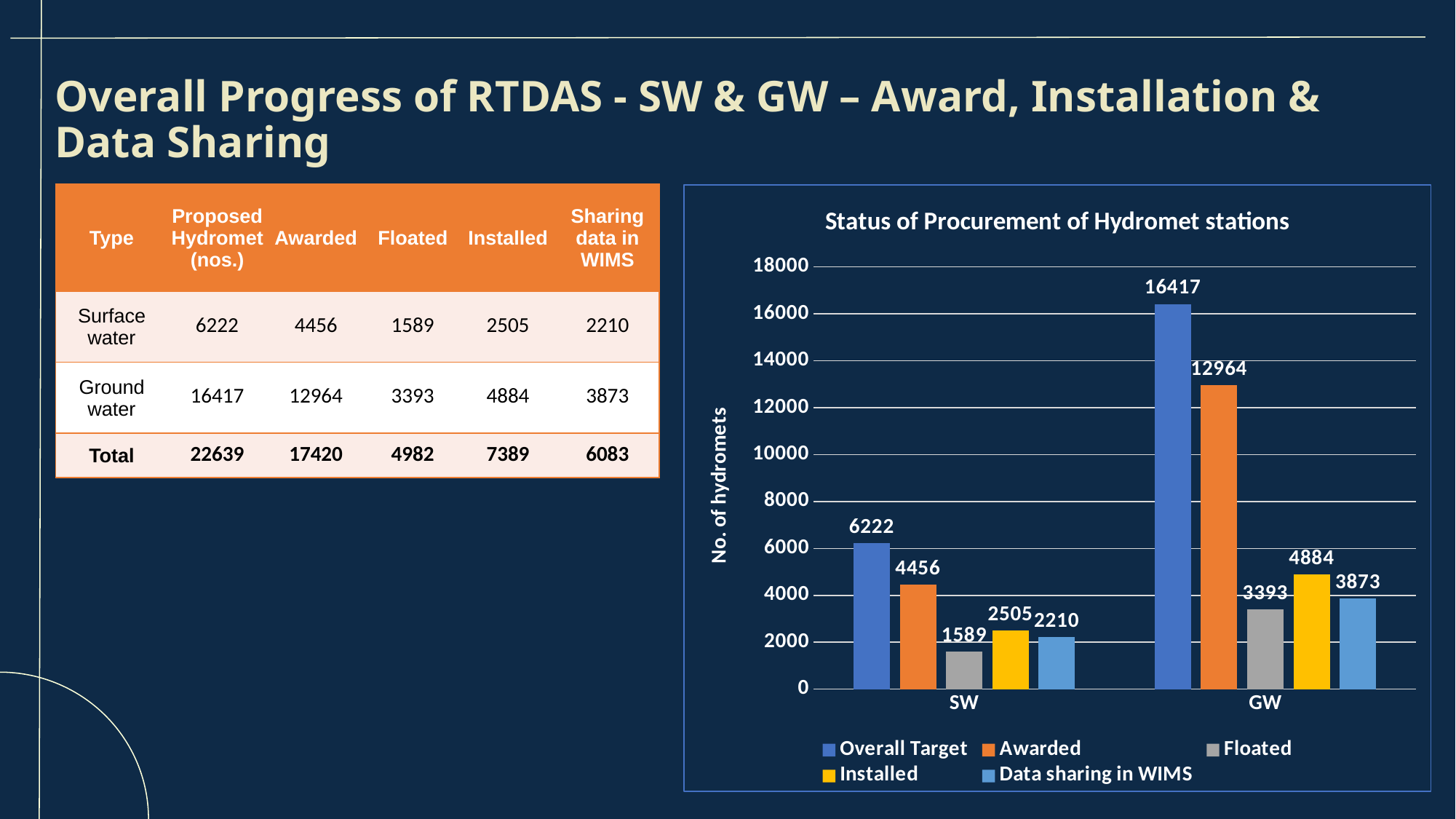
How many categories are shown on the x axis of the chart? 2 What is the difference between the Overall Target and Awarded values for GW in the chart? 3453 What is the Data sharing in WIMS value for SW in the chart? 2210 Is the Awarded value for GW greater or less than 12000 in the chart? greater What is the Awarded value for SW in the chart? 4456 How many series does the chart legend list? 5 Which series has the lowest value for GW in the chart? Floated What type of chart is shown on the slide? bar chart What is the Installed value for GW in the chart? 4884 Which is larger in the chart: the Installed value for SW or the Data sharing in WIMS value for SW? Installed Which series has the highest value for SW in the chart? Overall Target What is the Overall Target value for GW in the chart? 16417